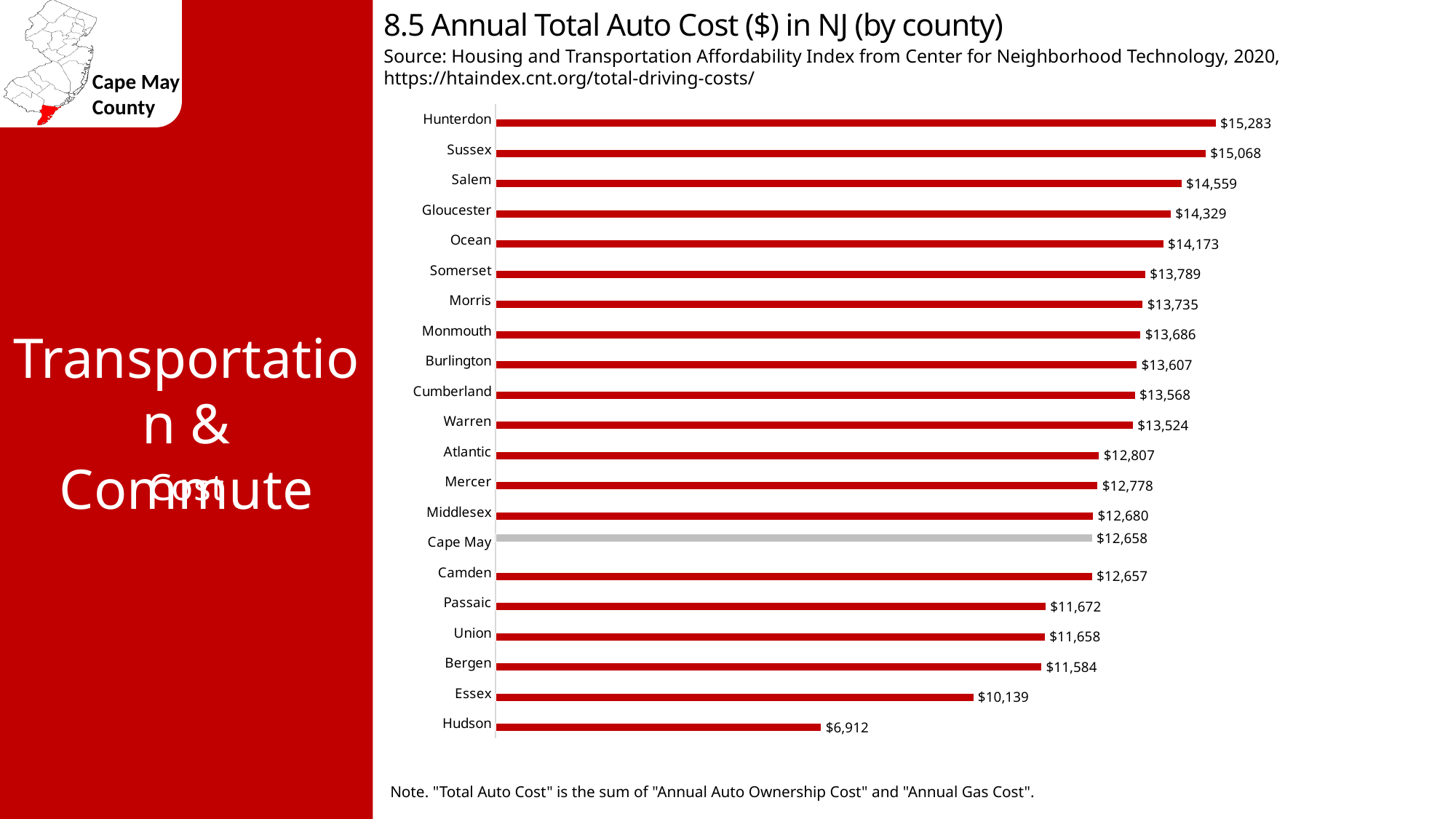
Which county has a higher annual total auto cost, Bergen or Essex? Bergen What is the annual total auto cost for Cape May county? $12,658 How many counties are shown in the chart? 21 What is the difference in annual total auto cost between Hunterdon and Hudson counties? $8,371 What is the annual total auto cost for Hudson county? $6,912 Which county has the lowest annual total auto cost? Hudson Which county has the highest annual total auto cost? Hunterdon Which county's bar is shown in a different colour (grey) from the others? Cape May Which county has a higher annual total auto cost, Salem or Ocean? Salem What is the annual total auto cost for Gloucester county? $14,329 What type of chart is shown on the slide? Bar chart What is the difference in annual total auto cost between Essex and Hudson counties? $3,227